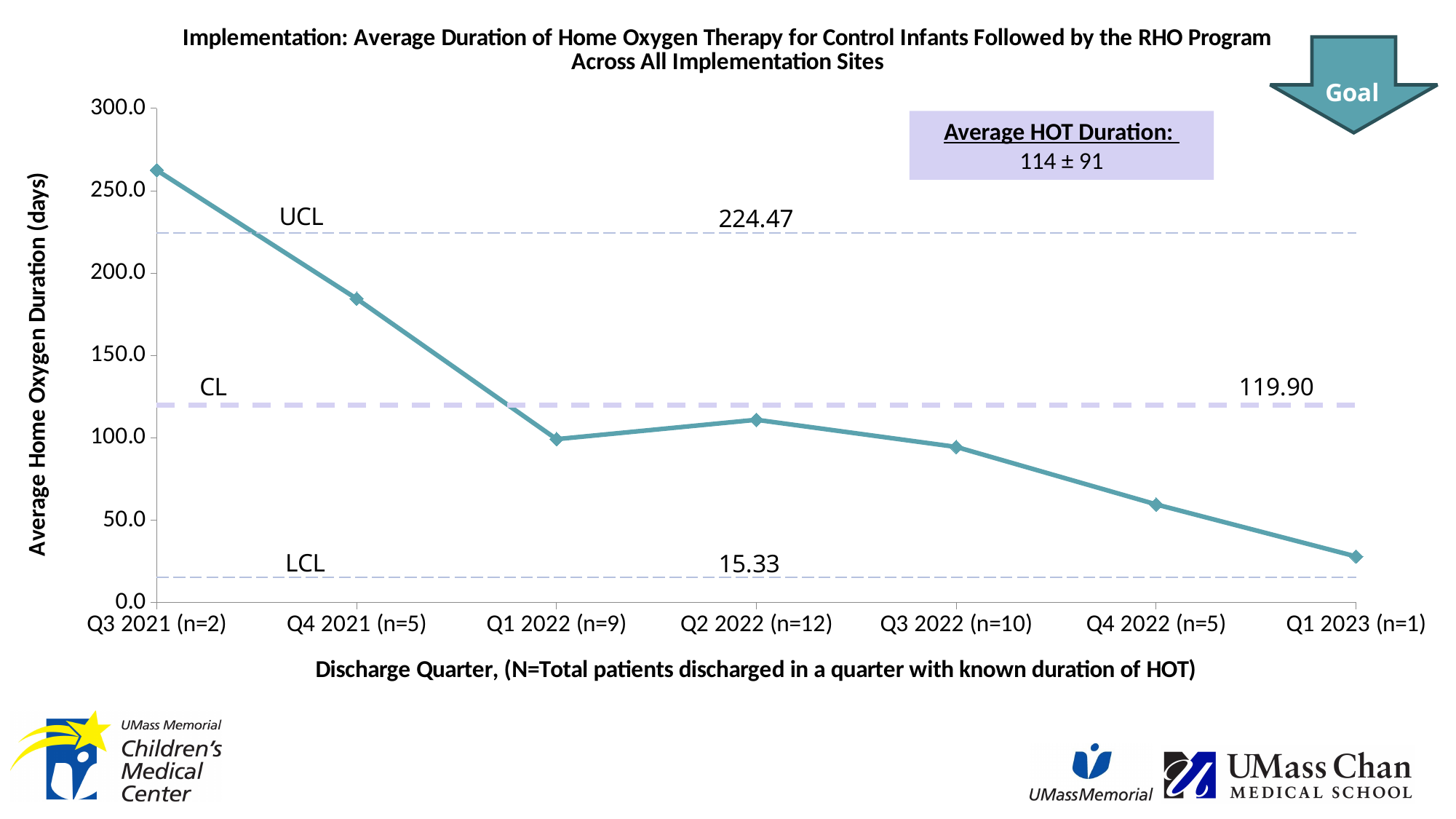
What is the value of the upper control limit (UCL) shown on the chart? 224.47 Is the average home oxygen duration for Q3 2021 (n=2) greater or less than 250? greater How many discharge quarters are plotted on the x axis? 7 What is the difference between the UCL and the LCL values? 209.14 What is the value of the center line (CL) shown on the chart? 119.90 Is the average home oxygen duration for Q1 2023 (n=1) greater or less than 50? less Which has a higher average home oxygen duration, Q4 2021 (n=5) or Q4 2022 (n=5)? Q4 2021 (n=5) What is the average HOT duration stated in the box on the chart? 114 ± 91 Which discharge quarter has the highest average home oxygen duration? Q3 2021 (n=2) What is the value of the lower control limit (LCL) shown on the chart? 15.33 Which discharge quarter has the lowest average home oxygen duration? Q1 2023 (n=1) What kind of chart is shown on the slide? line chart